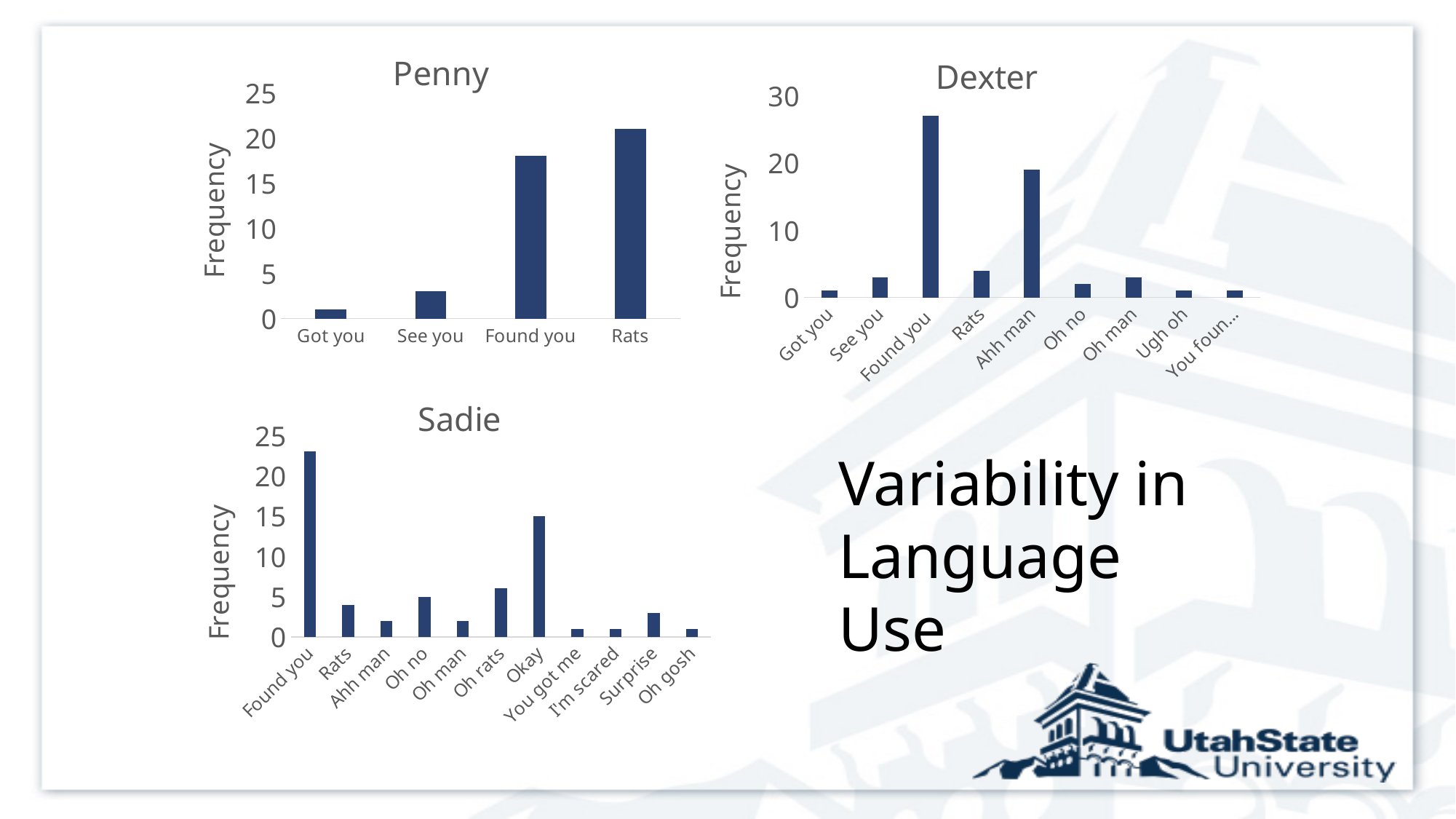
In the Penny chart, is the frequency for Found you greater or less than 15? greater In the Dexter chart, which is larger, the frequency for Ahh man or the frequency for Rats? Ahh man In the Penny chart, which category has the highest frequency? Rats What type of chart is the Sadie chart? Bar chart What is the label on the vertical axis of the Dexter chart? Frequency How many categories are shown on the x axis of the Penny chart? 4 In the Sadie chart, which category has the highest frequency? Found you In the Sadie chart, is the frequency for Okay greater or less than 10? greater In the Dexter chart, which category has the highest frequency? Found you In the Dexter chart, is the frequency for Found you greater or less than 20? greater In the Penny chart, which category has the lowest frequency? Got you In the Sadie chart, which is larger, the frequency for Oh rats or the frequency for Surprise? Oh rats